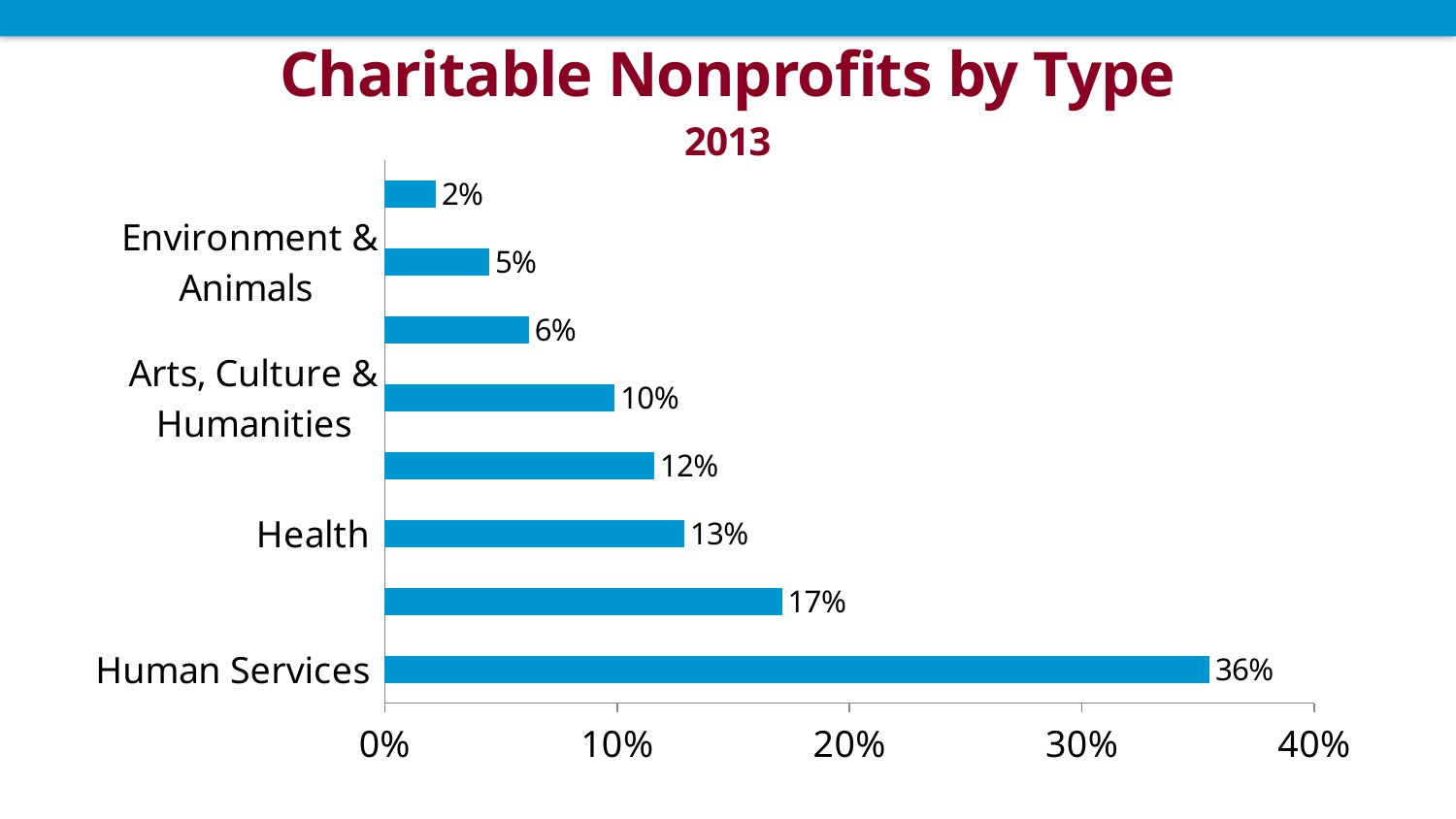
How many bars are plotted in the chart? 8 What is the value shown for Health? 13% Which is larger, the value for Health or the value for Arts, Culture & Humanities? Health What percentage of charitable nonprofits are Human Services organizations? 36% What is the difference between the Arts, Culture & Humanities value and the Environment & Animals value? 5% Is the value for Human Services greater or less than 30%? greater What is the difference between the Human Services value and the Health value? 23% What is the smallest value shown on any bar in the chart? 2% What is the value shown for Environment & Animals? 5% What is the value shown for Arts, Culture & Humanities? 10% Which labeled category has the highest value? Human Services What kind of chart is shown on the slide? Bar chart